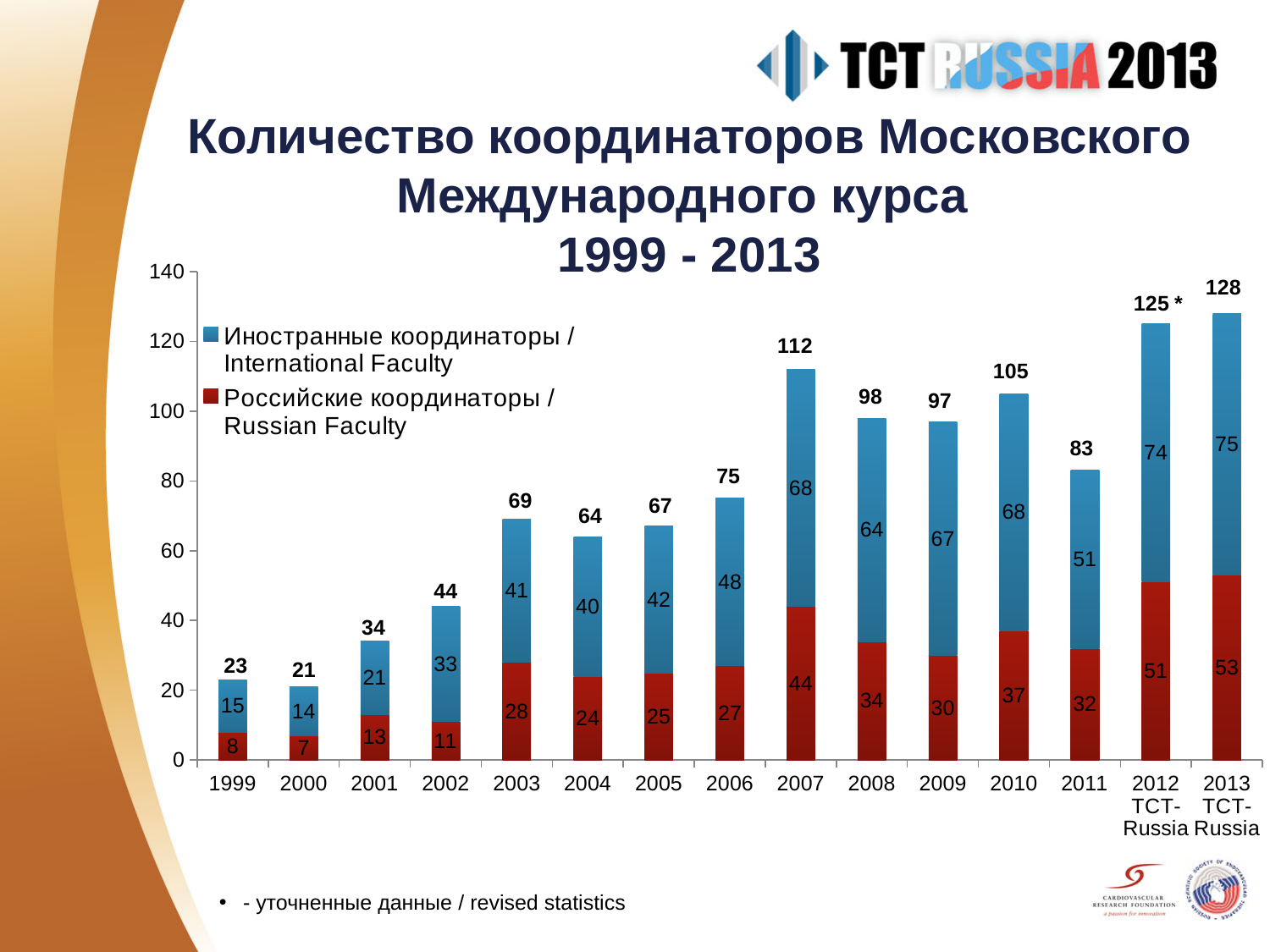
Is the total for 2011 greater or less than 100? less Which is larger: the International Faculty value in 2009 or in 2010? 2010 How many years (categories) are shown on the x axis? 15 Which year has the lowest total number of coordinators? 2000 Which year has the highest total number of coordinators? 2013 How many series does the legend list? 2 Which year's total label is marked with an asterisk indicating revised statistics? 2012 What is the difference between the total for 2007 and the total for 2008? 14 What type of chart is shown on the slide? stacked bar chart What is the total number of coordinators shown for 2010? 105 What is the value for Russian Faculty (Российские координаторы) in 2007? 44 What is the value for International Faculty (Иностранные координаторы) in 2003? 41